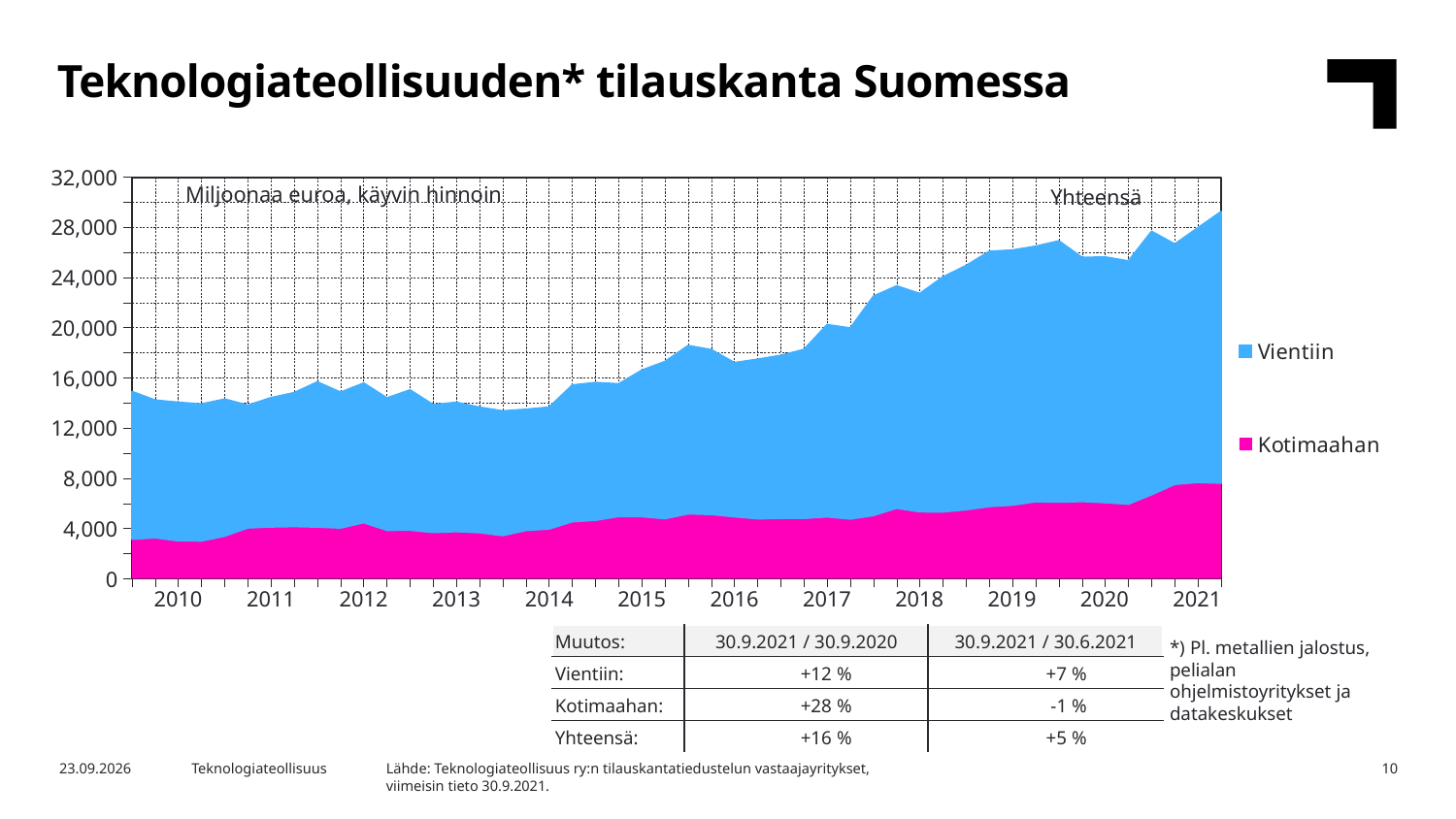
What are the two series named in the chart legend? Vientiin and Kotimaahan Is the total (Yhteensä) value at the start of 2010 greater or less than 16,000? less In which year does the total (Yhteensä) reach its highest level on the chart? 2021 Is the total (Yhteensä) value at the end of 2021 greater or less than 28,000? greater What kind of chart is shown on the slide? Stacked area chart What unit label is shown inside the chart area? Miljoonaa euroa, käyvin hinnoin Is the Kotimaahan value at the start of 2010 greater or less than 4,000? less How many series does the chart legend list? 2 Does the total order book (Yhteensä) generally rise or fall from 2010 to 2021? Rise Which series is larger throughout the chart, Vientiin or Kotimaahan? Vientiin How many years are labelled on the x axis? 12